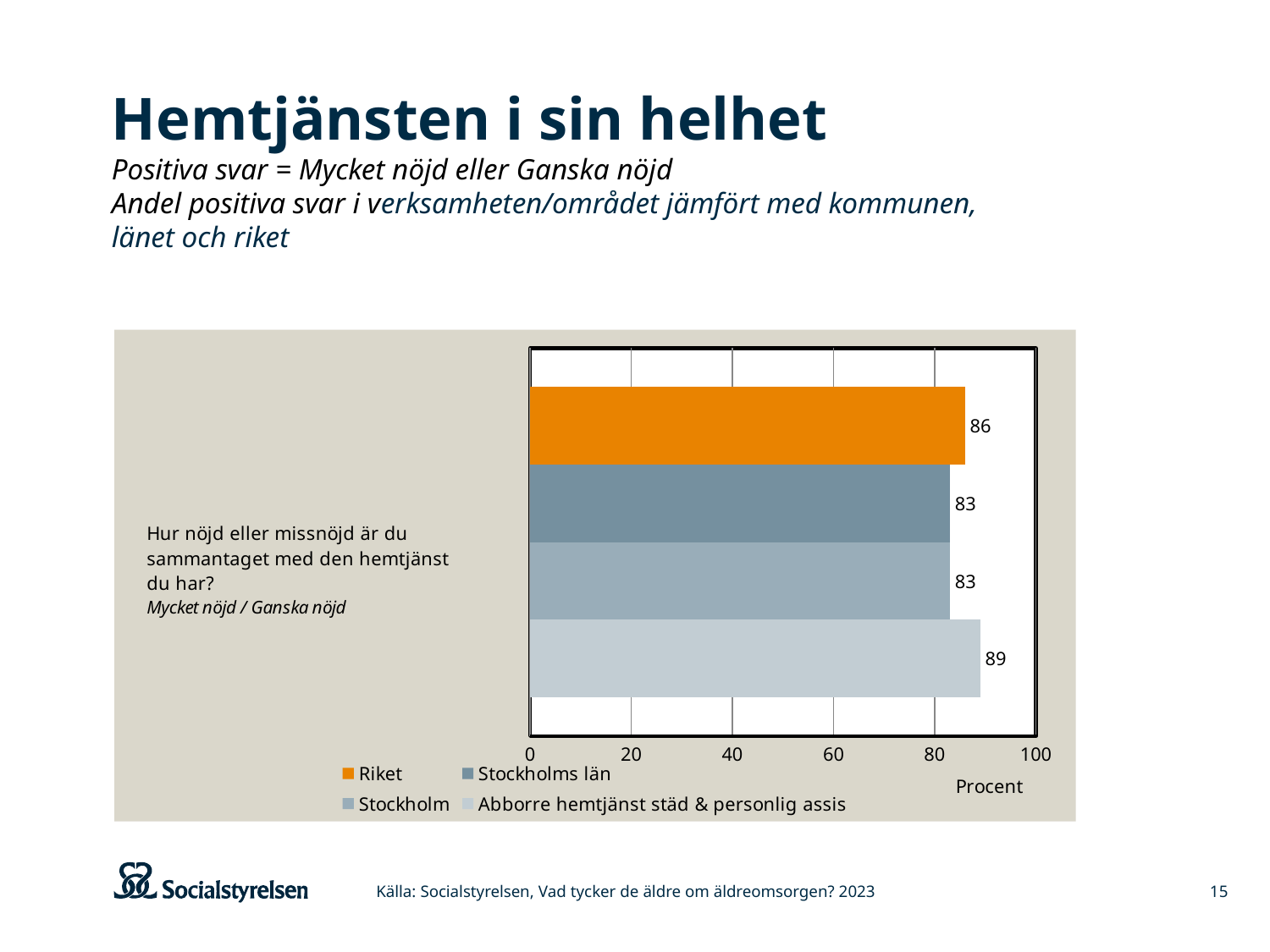
What is the value for Stockholms län? 83 What is the difference between the values for Abborre hemtjänst städ & personlig assis and Riket? 3 Which series has the highest value? Abborre hemtjänst städ & personlig assis How many series does the legend list? 4 What is the label on the horizontal axis? Procent What is the difference between the values for Riket and Stockholm? 3 Which series is shown in orange? Riket What kind of chart is shown on the slide? bar chart Is the value for Stockholm greater or less than 80? greater Which is larger, the value for Riket or the value for Stockholms län? Riket What is the value for Abborre hemtjänst städ & personlig assis? 89 What is the value for Riket? 86